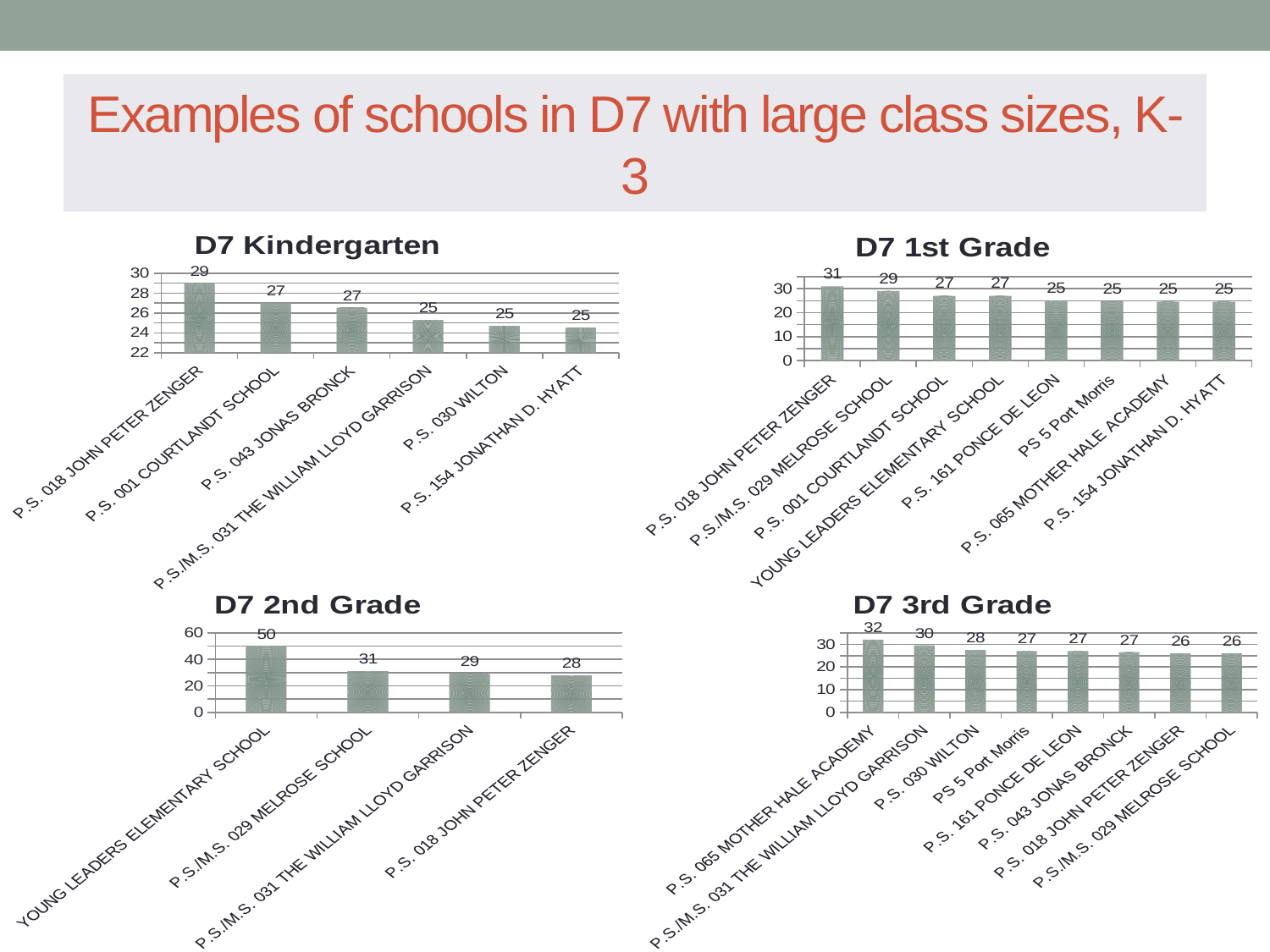
How many schools are shown in the D7 1st Grade chart? 8 In the D7 1st Grade chart, what is the difference between P.S. 018 JOHN PETER ZENGER and P.S. 154 JONATHAN D. HYATT? 6 How many schools are shown in the D7 Kindergarten chart? 6 In the D7 3rd Grade chart, what is the value for P.S. 065 MOTHER HALE ACADEMY? 32 What type of chart is the D7 3rd Grade chart? Bar chart In the D7 1st Grade chart, what is the value for P.S./M.S. 029 MELROSE SCHOOL? 29 In the D7 2nd Grade chart, what is the value for YOUNG LEADERS ELEMENTARY SCHOOL? 50 In the D7 3rd Grade chart, which is larger, the value for P.S./M.S. 031 THE WILLIAM LLOYD GARRISON or the value for P.S. 030 WILTON? P.S./M.S. 031 THE WILLIAM LLOYD GARRISON In the D7 2nd Grade chart, is the value for YOUNG LEADERS ELEMENTARY SCHOOL greater or less than 40? greater In the D7 2nd Grade chart, which school has the lowest value? P.S. 018 JOHN PETER ZENGER In the D7 Kindergarten chart, which school has the highest value? P.S. 018 JOHN PETER ZENGER In the D7 Kindergarten chart, what is the value for P.S. 018 JOHN PETER ZENGER? 29